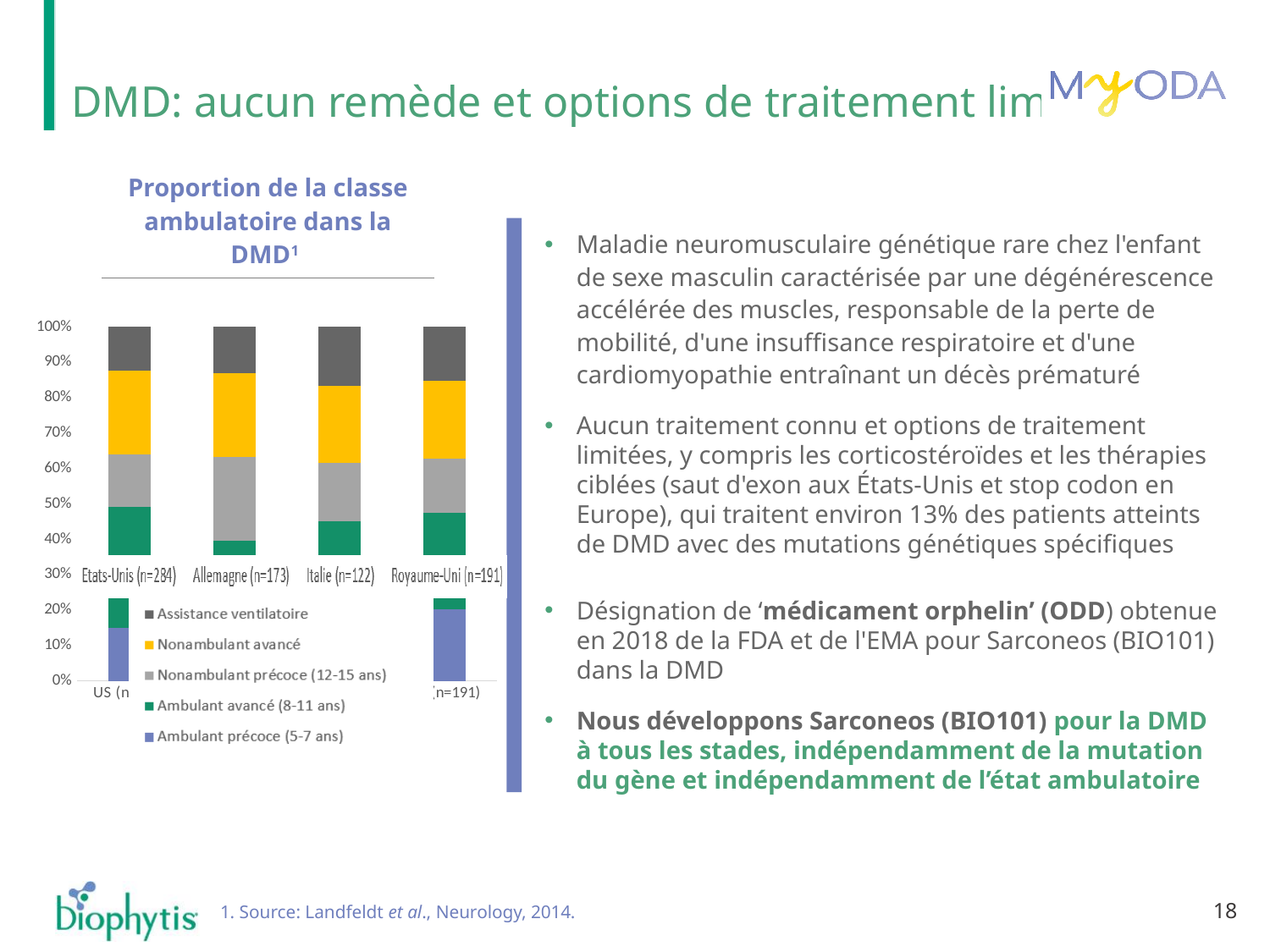
Is the cumulative top of the Nonambulant avancé segment for Allemagne greater or less than 80%? greater What sample size (n) is given for Italie in the chart? n=122 What kind of chart is shown on the slide? Stacked bar chart How many series does the chart legend list? 5 Which series is shown in yellow in the chart? Nonambulant avancé Is the cumulative top of the Nonambulant avancé segment for Etats-Unis greater or less than 80%? greater What is the title of the chart on the slide? Proportion de la classe ambulatoire dans la DMD What sample size (n) is given for Etats-Unis in the chart? n=284 How many countries (categories) are shown on the x axis of the chart? 4 Is the cumulative top of the Nonambulant précoce (12-15 ans) segment for Etats-Unis greater or less than 60%? greater Which country has the larger Nonambulant précoce (12-15 ans) segment, Allemagne or Etats-Unis? Allemagne Which country has the larger Assistance ventilatoire segment, Italie or Etats-Unis? Italie